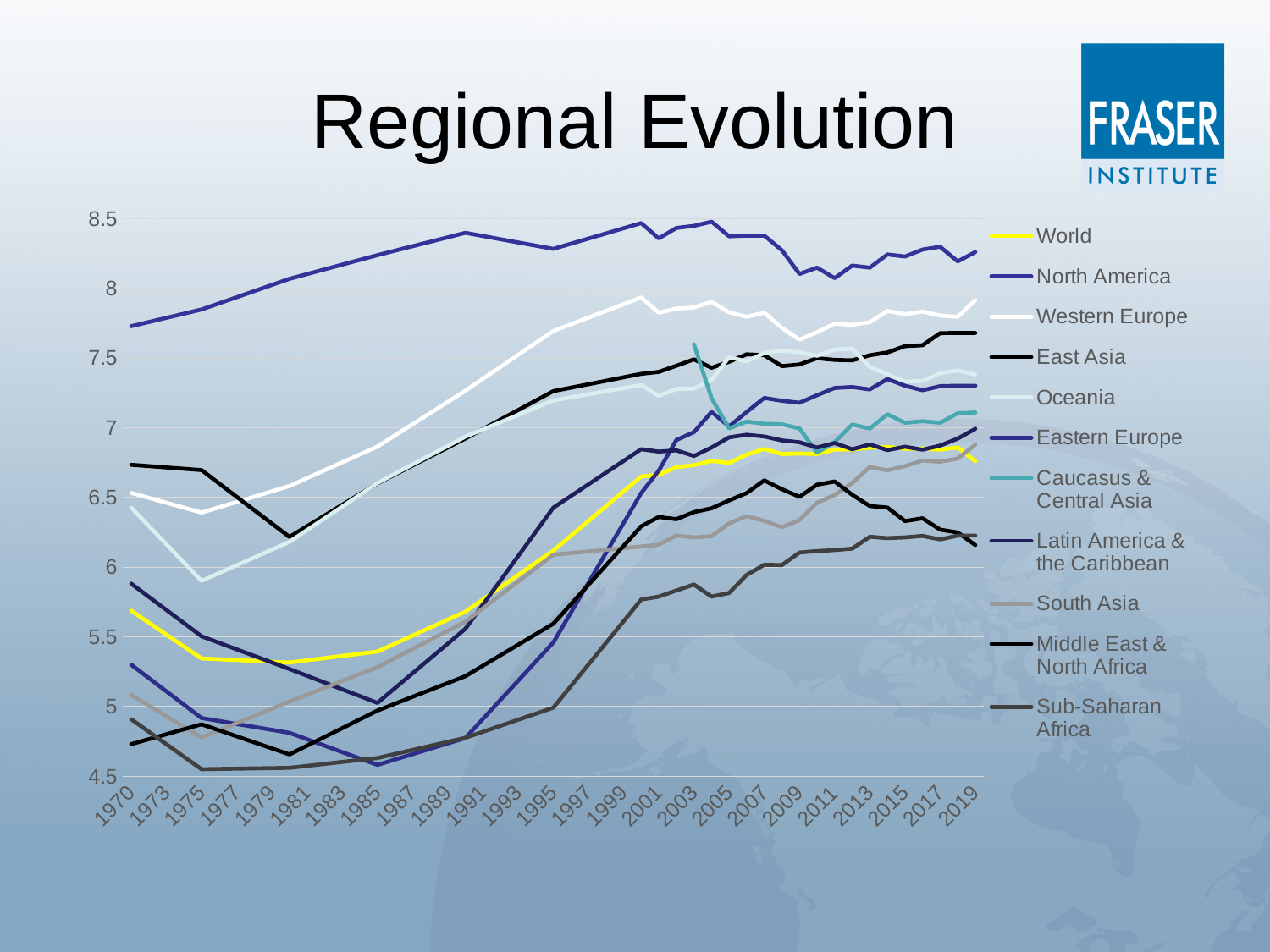
Does the World line rise or fall overall from 1970 to 2019? Rises In 2019, which is higher: North America or Western Europe? North America Is the value for Sub-Saharan Africa in 1981 greater or less than 5? less What kind of chart is shown on the slide? Line chart Which series has the lowest value in 1975? Sub-Saharan Africa How many series does the legend list? 11 What is the title of the chart? Regional Evolution Is the value for North America in 2001 greater or less than 8? greater Is the value for World in 1975 greater or less than 5.5? less In 2019, which is higher: East Asia or Oceania? East Asia Which series has the highest values across the whole chart? North America